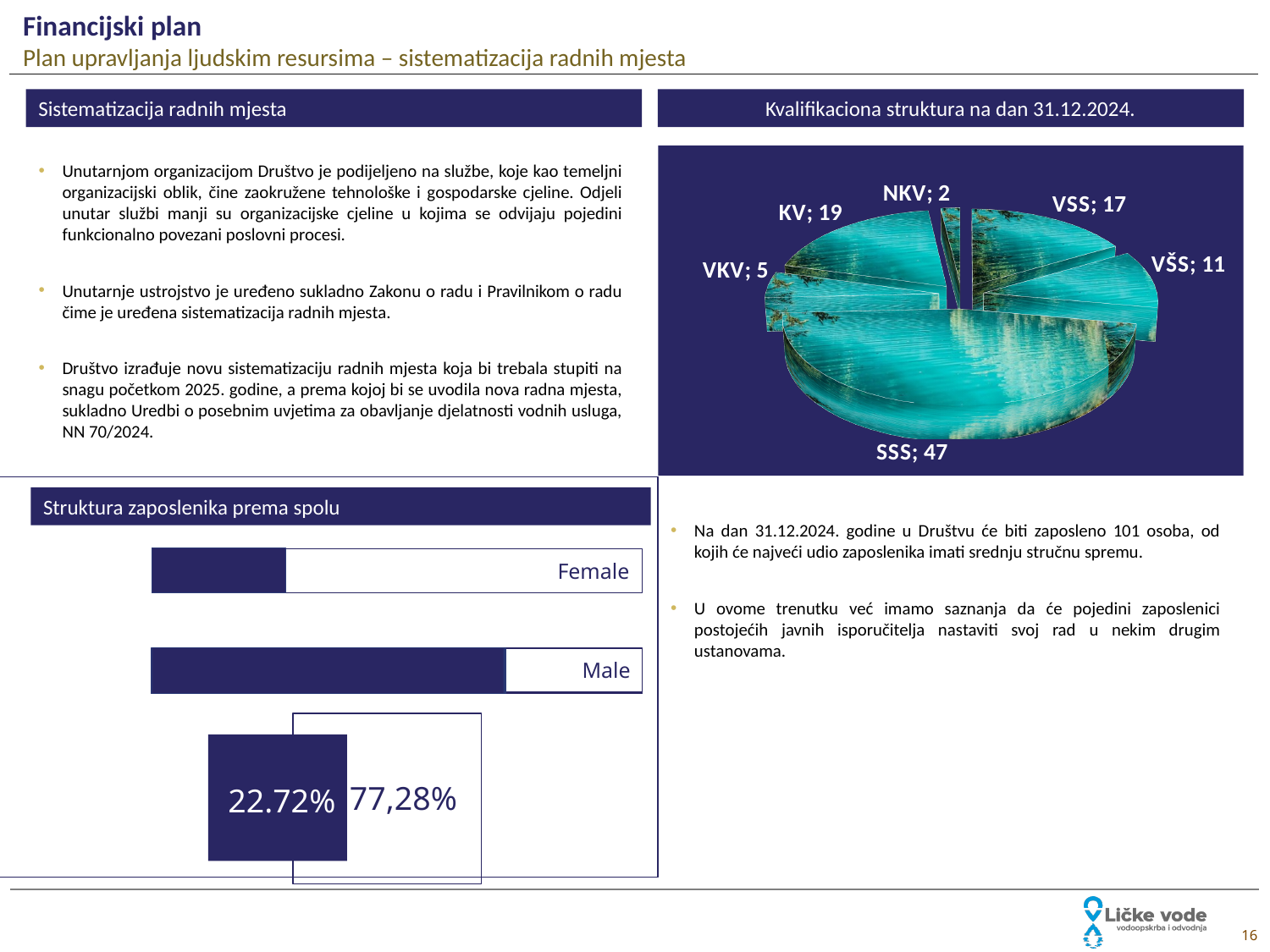
In the pie chart 'Kvalifikaciona struktura na dan 31.12.2024.', what is the value for VKV? 5 In the pie chart 'Kvalifikaciona struktura na dan 31.12.2024.', what is the difference between the values for SSS and KV? 28 In the pie chart 'Kvalifikaciona struktura na dan 31.12.2024.', which category has the smallest value? NKV In the pie chart 'Kvalifikaciona struktura na dan 31.12.2024.', what is the difference between the values for KV and VSS? 2 In the pie chart 'Kvalifikaciona struktura na dan 31.12.2024.', what is the value for NKV? 2 What is the sum of all the values shown in the pie chart 'Kvalifikaciona struktura na dan 31.12.2024.'? 101 What is the title of the pie chart on the right side of the slide? Kvalifikaciona struktura na dan 31.12.2024. What kind of chart is used for 'Kvalifikaciona struktura na dan 31.12.2024.'? pie chart How many categories are shown in the pie chart 'Kvalifikaciona struktura na dan 31.12.2024.'? 6 In the pie chart 'Kvalifikaciona struktura na dan 31.12.2024.', which category has the largest value? SSS In the pie chart 'Kvalifikaciona struktura na dan 31.12.2024.', which is larger, VSS or VŠS? VSS In the pie chart 'Kvalifikaciona struktura na dan 31.12.2024.', what is the value for SSS? 47